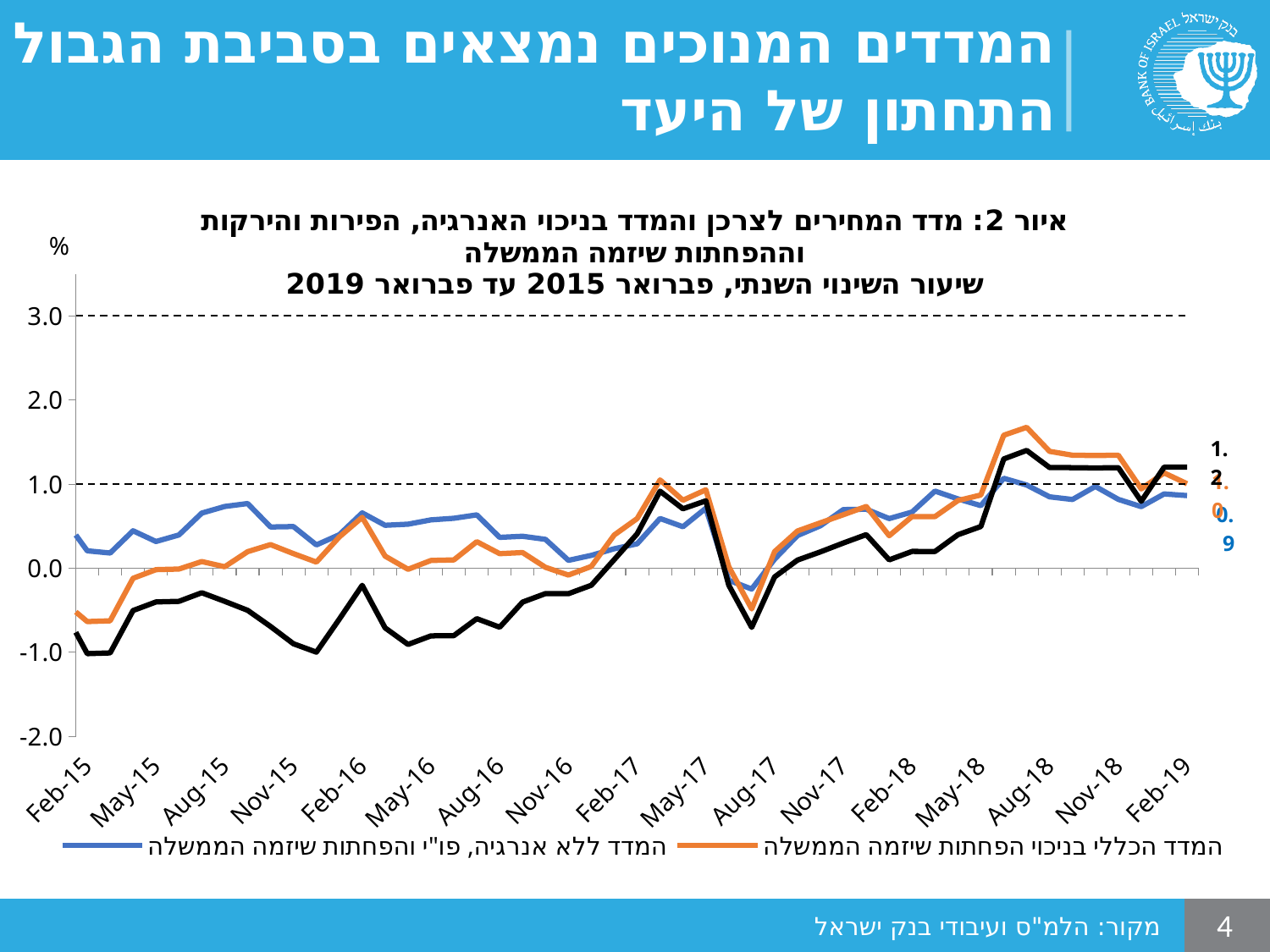
Is the value of the black line at Feb-19 greater or less than 1.0? greater How many lines are plotted on the chart? 3 Is the value of the black line at Feb-15 greater or less than 0.0? less What kind of chart is shown on the slide? line chart Which series does the blue line represent according to the legend? המדד ללא אנרגיה, פו"י והפחתות שיזמה הממשלה Is the value of the orange line at Aug-18 greater or less than 1.0? greater At Aug-18, which is larger: the orange line or the blue line? the orange line Which line reaches the highest value on the chart? the orange line At Feb-15, which is larger: the blue line or the black line? the blue line At what values are the two horizontal dashed lines drawn on the chart? 1.0 and 3.0 Does the black line rise or fall overall from Feb-15 to Feb-19? rise